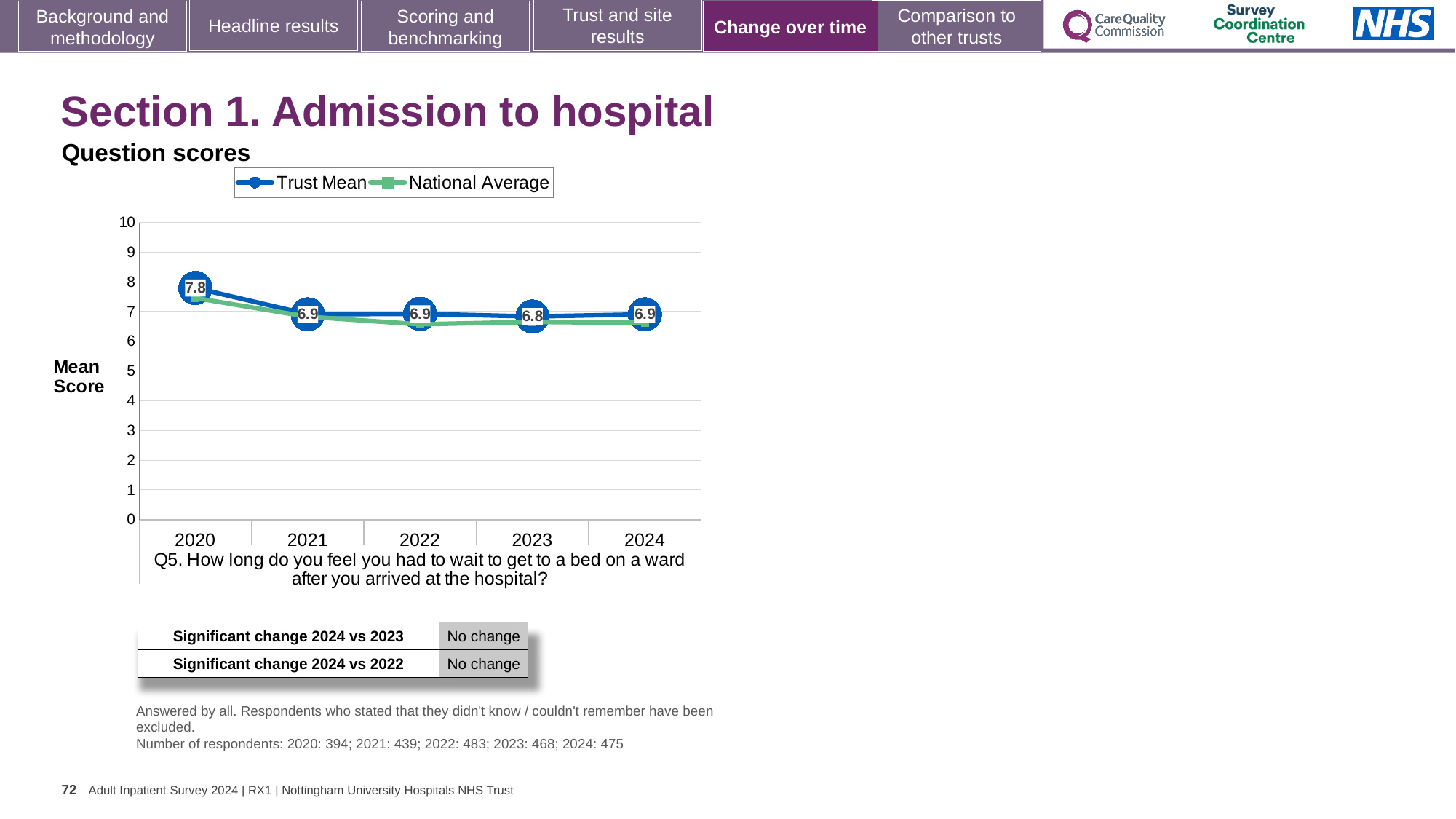
Is the National Average value for 2020 greater or less than 7? greater What kind of chart is shown? Line chart In which year is the Trust Mean lowest? 2023 What is the difference between the Trust Mean in 2020 and in 2021? 0.9 Does the Trust Mean rise or fall from 2020 to 2021? Fall What is the Trust Mean value for 2020? 7.8 Which is larger, the Trust Mean in 2020 or in 2024? 2020 In which year is the Trust Mean highest? 2020 What is the Trust Mean value for 2024? 6.9 How many years are plotted on the x axis? 5 What is the Trust Mean value for 2023? 6.8 How many series does the legend list? 2